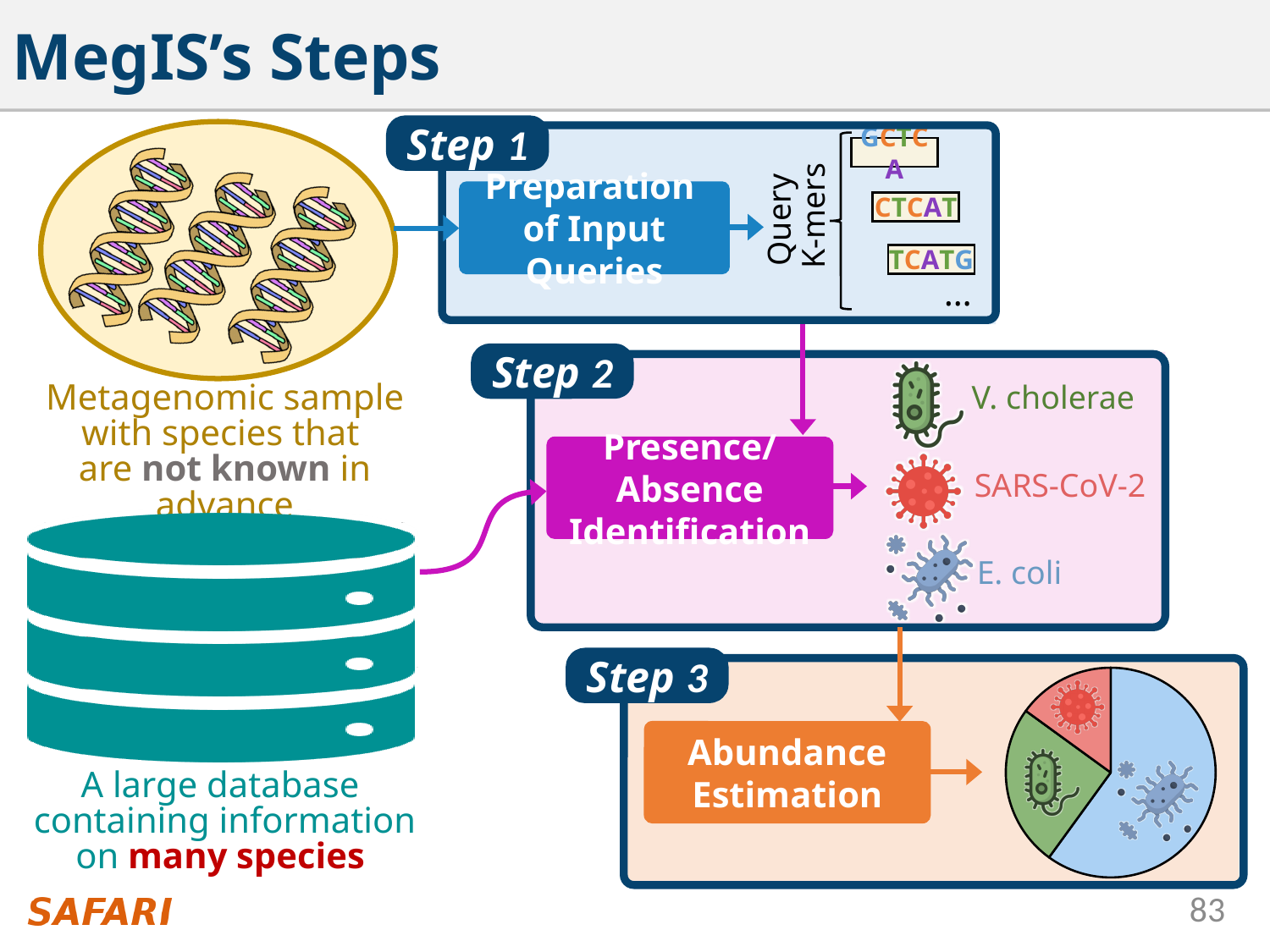
Which colour slice is the smallest in the Step 3 pie chart? red Which step's box contains the pie chart on the slide? Step 3 How many slices does the pie chart in Step 3 have? 3 What is the label of the orange box that points to the pie chart in Step 3? Abundance Estimation In the Step 3 pie chart, is the blue slice larger or smaller than the green slice? larger What kind of chart is shown in the Step 3 box of the slide? pie chart Which colour slice is the largest in the Step 3 pie chart? blue